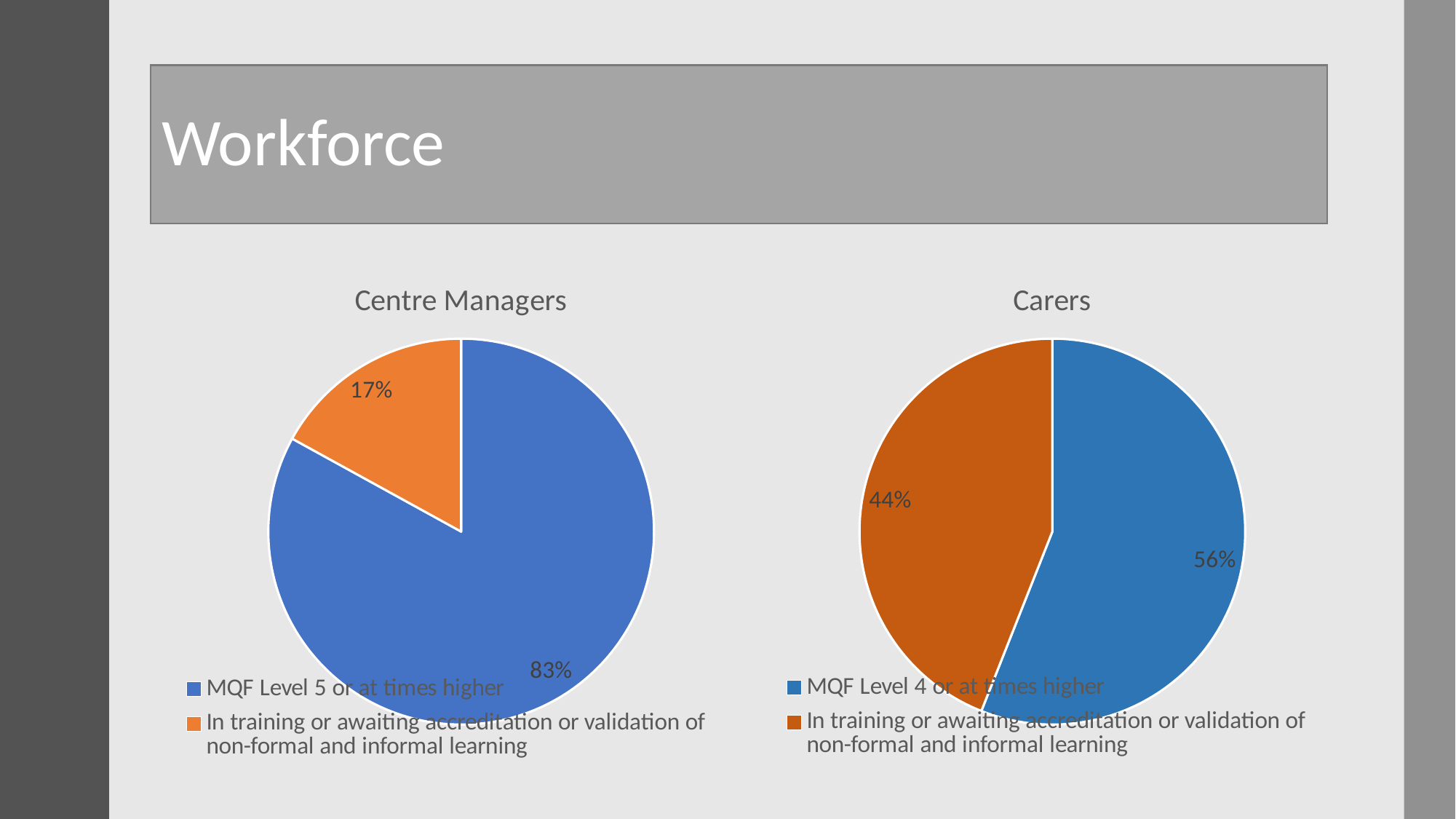
In the Centre Managers chart, which slice is the largest? MQF Level 5 or at times higher Which is larger: the 'In training' share in the Centre Managers chart or the 'In training' share in the Carers chart? Carers What kind of chart is the Carers chart? Pie chart In the Carers chart, what is the difference between the 'MQF Level 4 or at times higher' slice and the 'In training' slice? 12% In the Centre Managers chart, what is the difference between the 'MQF Level 5 or at times higher' slice and the 'In training' slice? 66% In the Carers chart, what share of the pie is labelled 'MQF Level 4 or at times higher'? 56% In the Centre Managers chart, what share of the pie is labelled 'MQF Level 5 or at times higher'? 83% How many slices does the Centre Managers pie chart have? 2 In the Carers chart, what share of the pie is 'In training or awaiting accreditation or validation of non-formal and informal learning'? 44% How many entries does the legend of the Carers chart list? 2 In the Carers chart, which slice is the smallest? In training or awaiting accreditation or validation of non-formal and informal learning